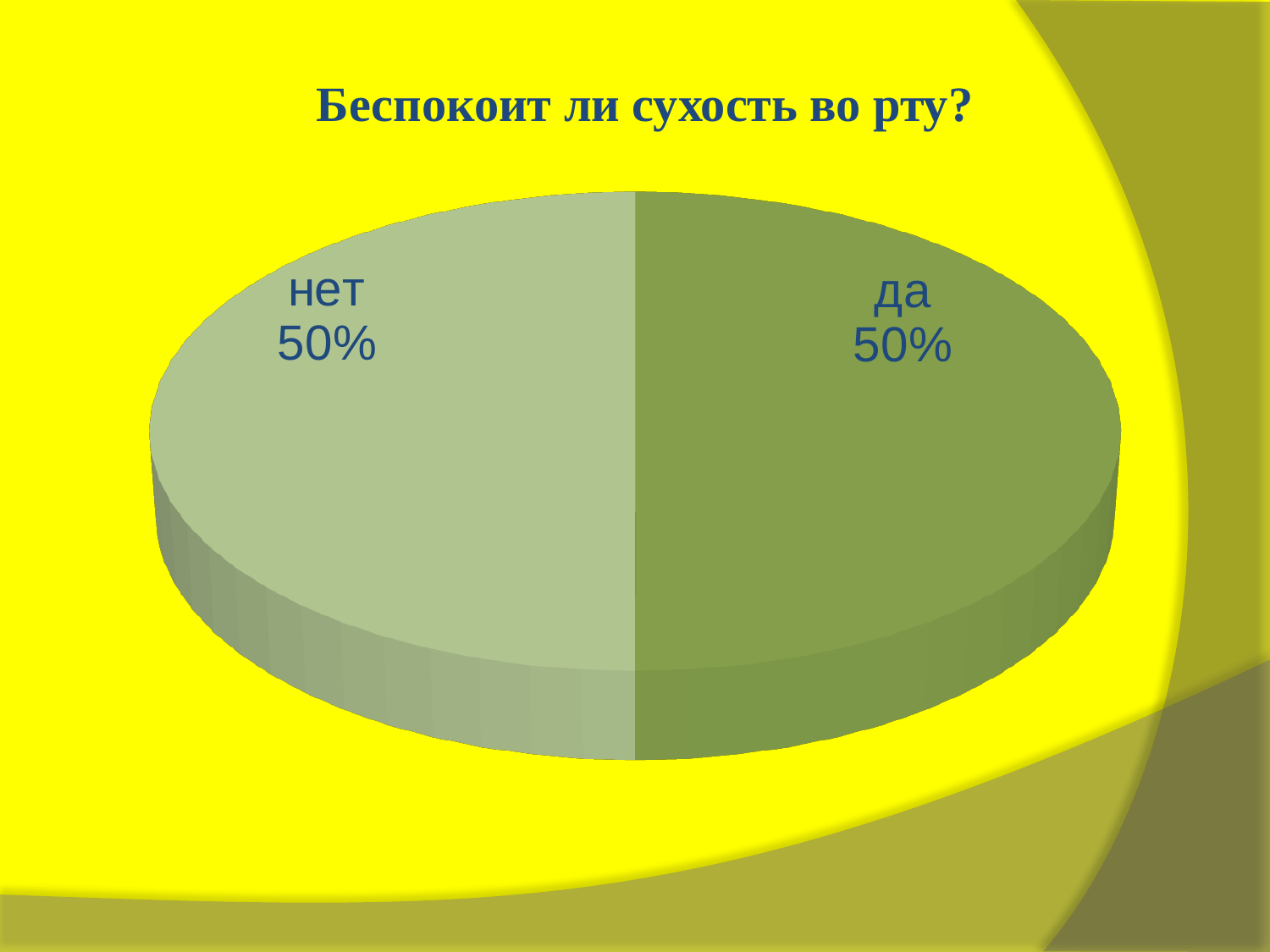
Which slice is labelled on the right side of the pie? да What is the difference between the "да" and "нет" shares? 0% What share of the pie does the "да" slice represent? 50% What is the title of the chart? Беспокоит ли сухость во рту? What share of the pie does the "нет" slice represent? 50% What kind of chart is shown on the slide? pie chart How many slices does the pie chart have? 2 What is the combined share of the "да" and "нет" slices? 100%